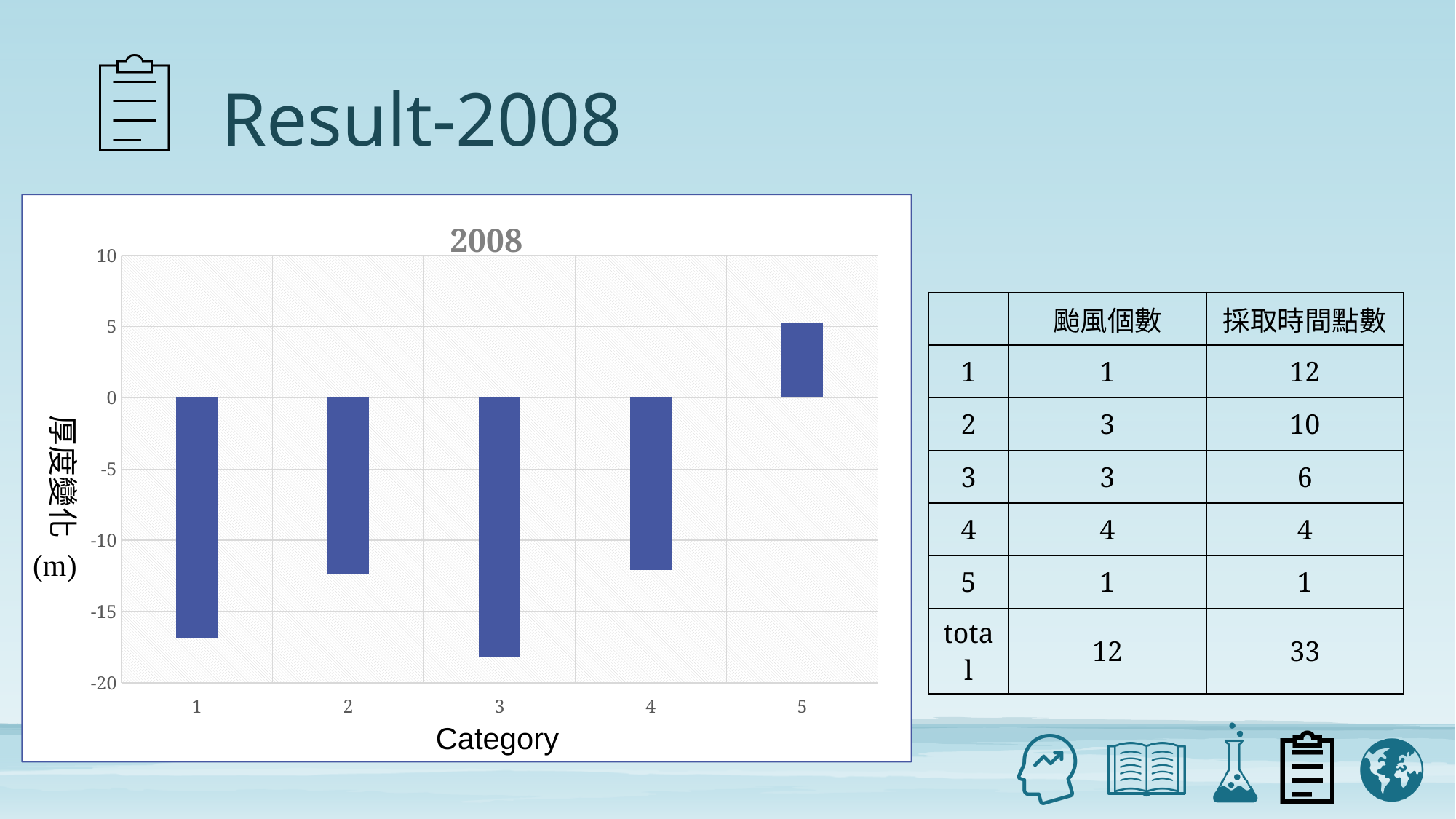
Which category has the lowest value on the chart? 3 Which has the larger value, category 4 or category 5? category 5 Is the value for category 1 greater or less than -15? less What is the title of the chart? 2008 Is the value for category 5 greater or less than 0? greater What is the label of the x axis of the chart? Category What kind of chart is shown on the slide? bar chart Is the value for category 2 greater or less than -15? greater Which has the larger value, category 1 or category 2? category 2 How many categories are plotted on the chart? 5 Which category has the highest value on the chart? 5